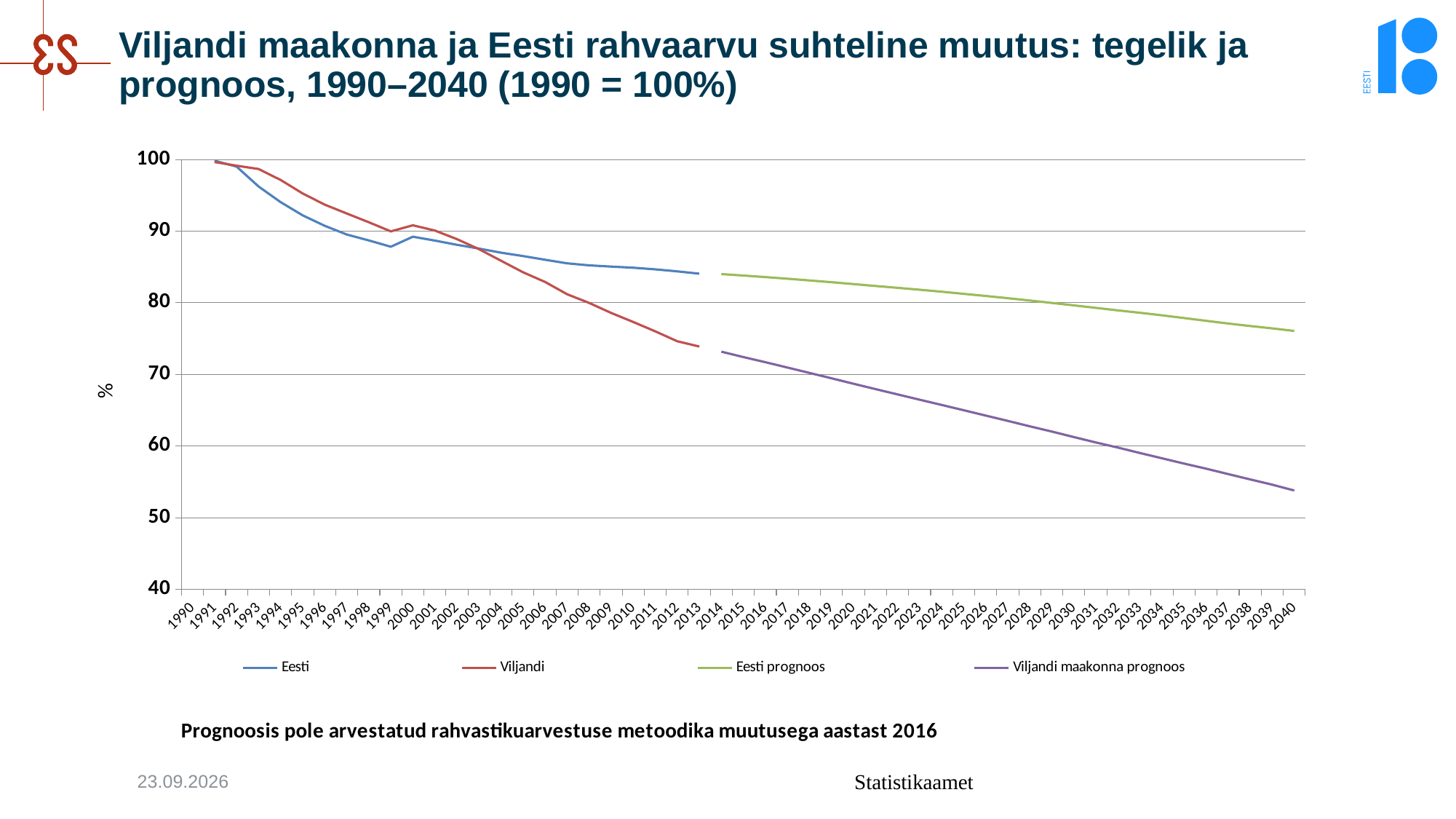
Which series is drawn in red? Viljandi What kind of chart is shown on the slide? line chart What is the label on the vertical axis? % Is the value for Eesti prognoos in 2040 greater or less than 70? greater Is the value for Eesti in 2013 greater or less than 80? greater Is the value for Viljandi maakonna prognoos in 2040 greater or less than 60? less How many series does the legend list? 4 In 2040, which series has the higher value, Eesti prognoos or Viljandi maakonna prognoos? Eesti prognoos Does the Viljandi maakonna prognoos line rise or fall from 2014 to 2040? fall In 2013, which series has the higher value, Eesti or Viljandi? Eesti